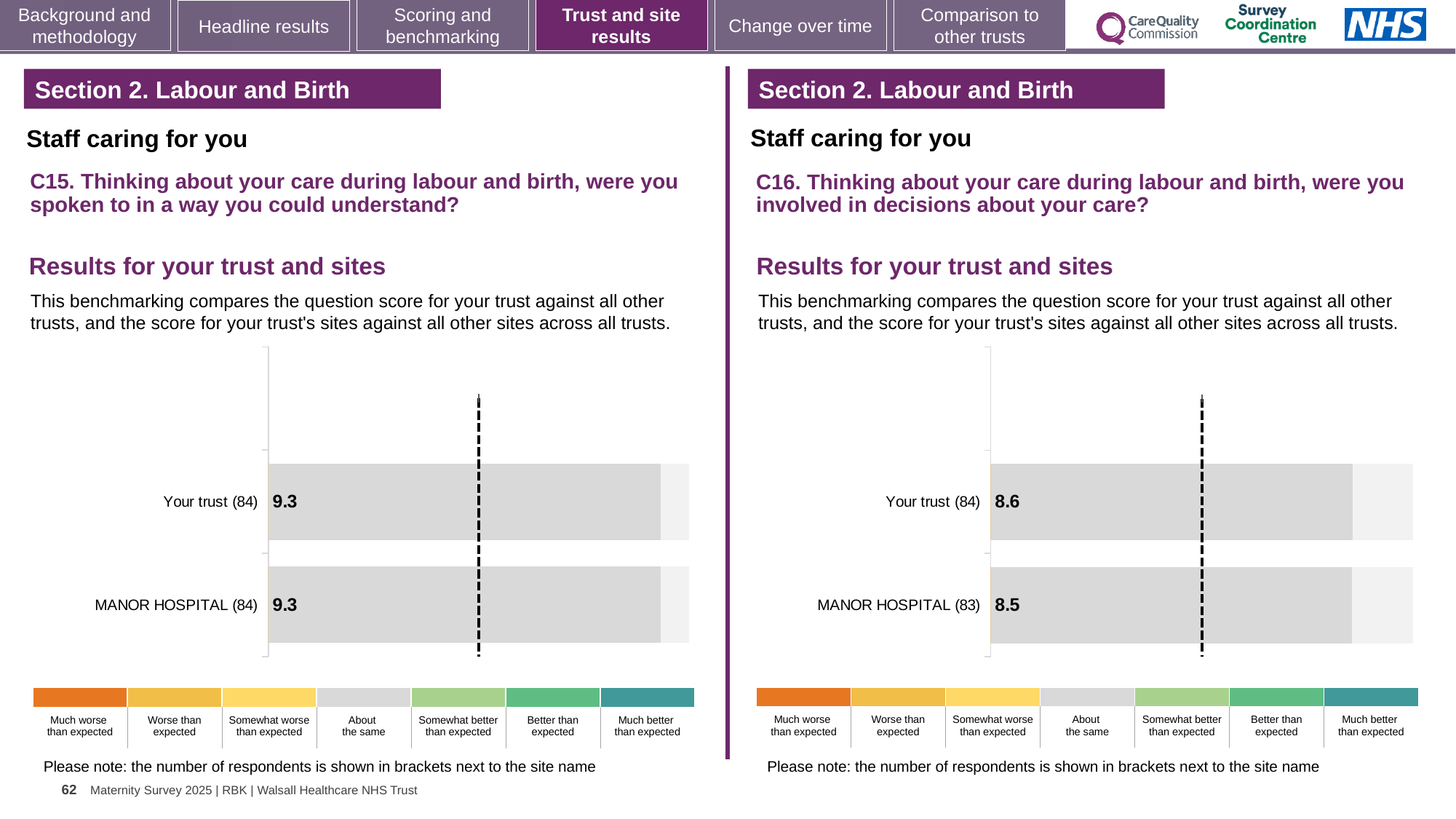
How many categories does the colour legend below the C15 chart on the left list? 7 In the C15 chart on the left, what is the score for Your trust? 9.3 How many rows (bars) are plotted in the C15 chart on the left? 2 In the C16 chart on the right, which has the higher score, Your trust or MANOR HOSPITAL? Your trust In the C16 chart on the right, what is the score for MANOR HOSPITAL? 8.5 What kind of chart is used for the C16 results on the right? Bar chart In the C16 chart on the right, how many respondents are shown in brackets for MANOR HOSPITAL? 83 In the C16 chart on the right, what is the score for Your trust? 8.6 In the C16 chart on the right, which row has the lowest score? MANOR HOSPITAL In the C15 chart on the left, what is the score for MANOR HOSPITAL? 9.3 In the C15 chart on the left, how many respondents are shown in brackets for Your trust? 84 In the C16 chart on the right, what is the difference between the score for Your trust and the score for MANOR HOSPITAL? 0.1